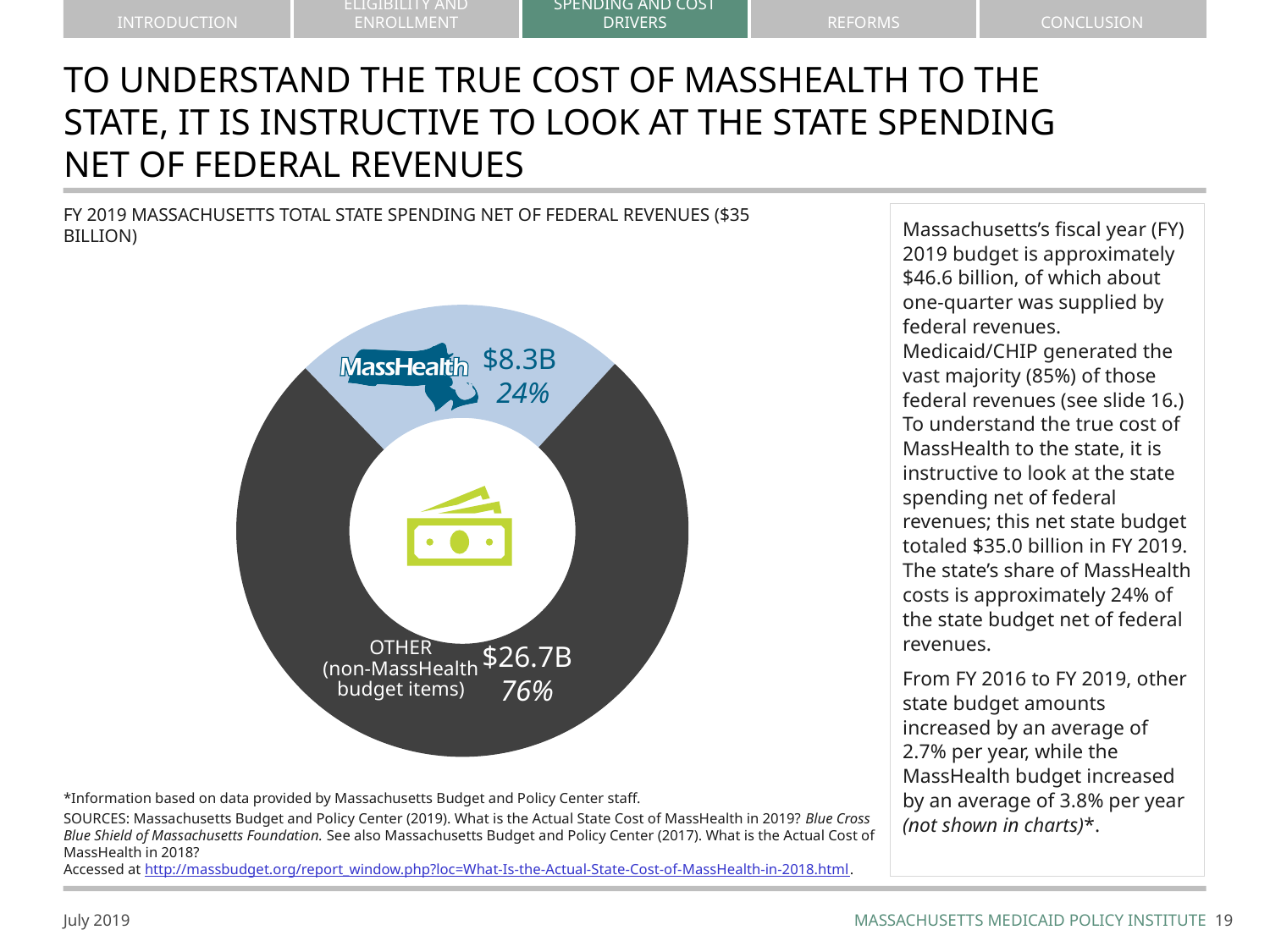
What is the value shown for MassHealth in the donut chart? $8.3B How many segments does the donut chart have? 2 What type of chart is shown on the slide? Donut (pie) chart Which is larger, the MassHealth segment or the OTHER segment? OTHER Which segment of the donut chart is the smallest? MassHealth Which segment of the donut chart is the largest? OTHER (non-MassHealth budget items) What is the title of the chart? FY 2019 Massachusetts Total State Spending Net of Federal Revenues ($35 Billion) What share of the donut chart does MassHealth represent? 24% What share of the donut chart does OTHER (non-MassHealth budget items) represent? 76% What is the difference in dollars between the OTHER segment and the MassHealth segment? $18.4B What is the total of the two segments shown in the donut chart? $35B What is the value shown for OTHER (non-MassHealth budget items) in the donut chart? $26.7B